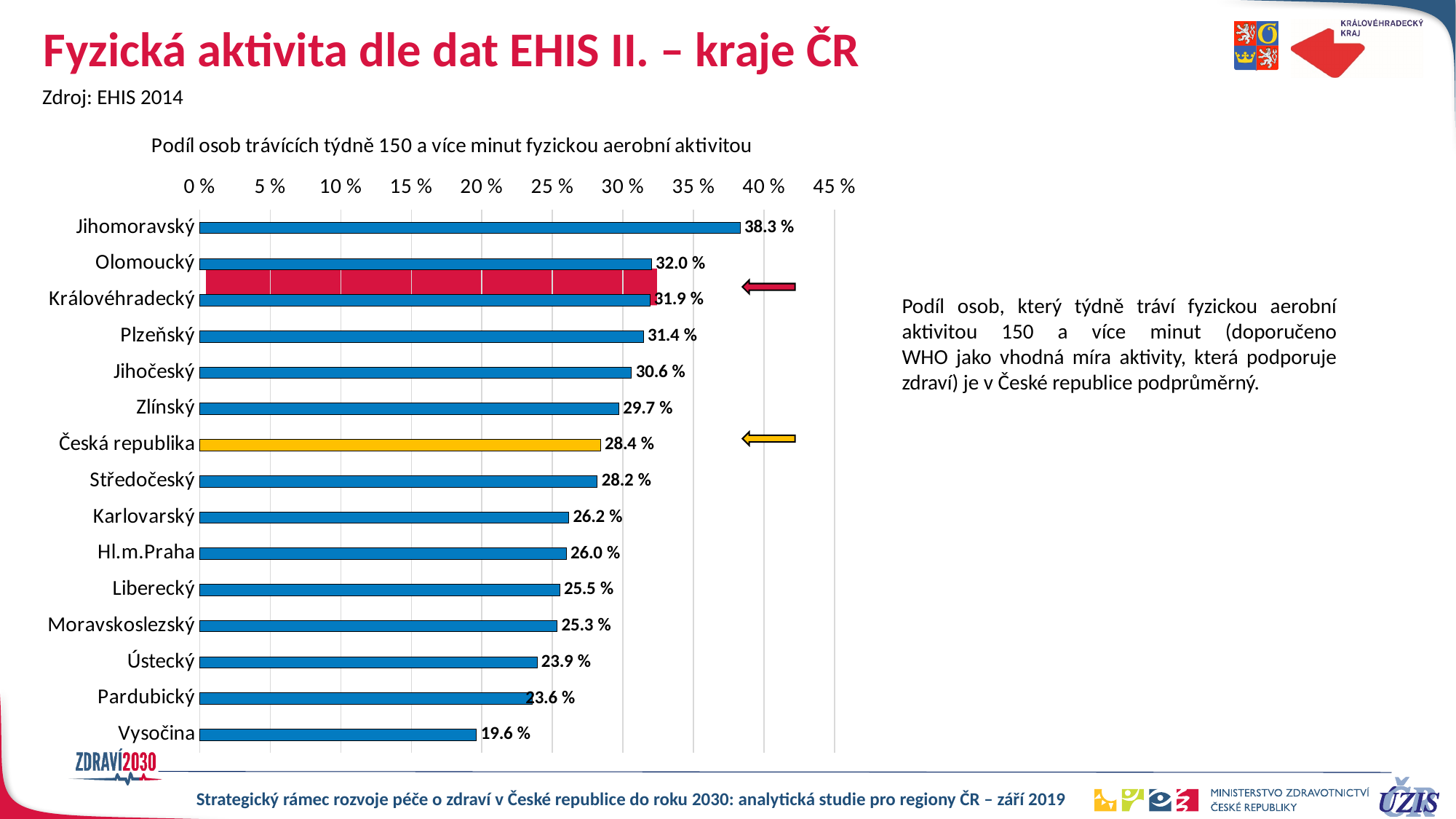
Is the value for Pardubický greater or less than 25 %? less How many bars are shown in the chart? 15 Which category has the lowest value? Vysočina Which category has the highest value? Jihomoravský What is the value for Česká republika? 28.4 % What is the value for Hl.m.Praha? 26.0 % What is the difference between the values for Jihomoravský and Vysočina? 18.7 % What kind of chart is shown on the slide? bar chart What is the value for Jihomoravský? 38.3 % Which has a larger value, Plzeňský or Ústecký? Plzeňský What is the value for Královéhradecký? 31.9 % What is the difference between the values for Královéhradecký and Česká republika? 3.5 %